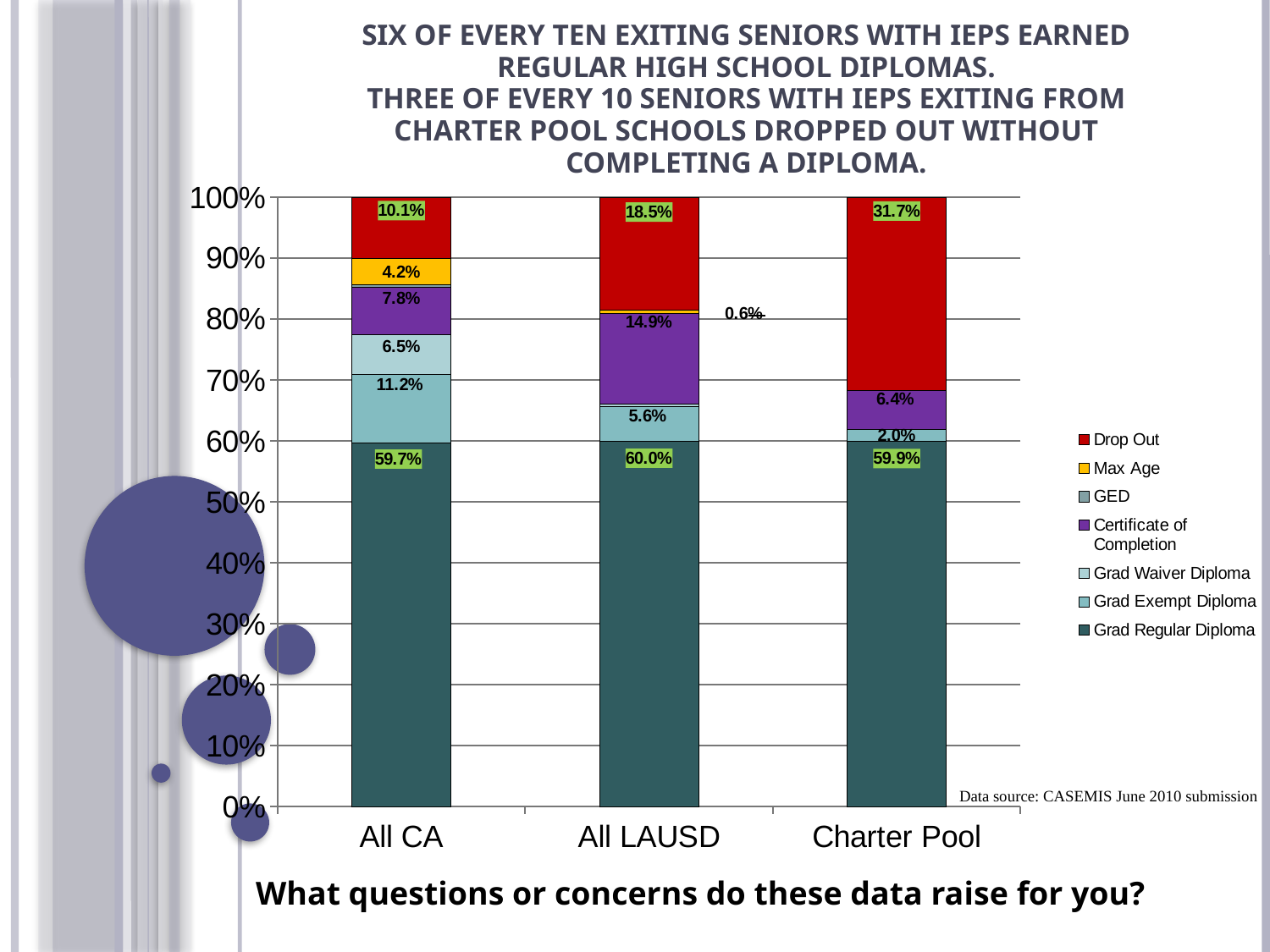
What is the Max Age percentage for All CA? 4.2% What kind of chart is shown on the slide? Stacked bar chart Which has a larger Certificate of Completion percentage, All CA or Charter Pool? All CA What is the difference in Drop Out percentage between Charter Pool and All CA? 21.6 percentage points Which group has the highest Drop Out percentage? Charter Pool How many groups are shown on the x axis? 3 What is the Grad Exempt Diploma percentage for All CA? 11.2% Which group has the lowest Drop Out percentage? All CA How many series does the legend list? 7 What is the Certificate of Completion percentage for All LAUSD? 14.9% What is the Drop Out percentage for Charter Pool? 31.7% What is the Grad Regular Diploma percentage for All LAUSD? 60.0%